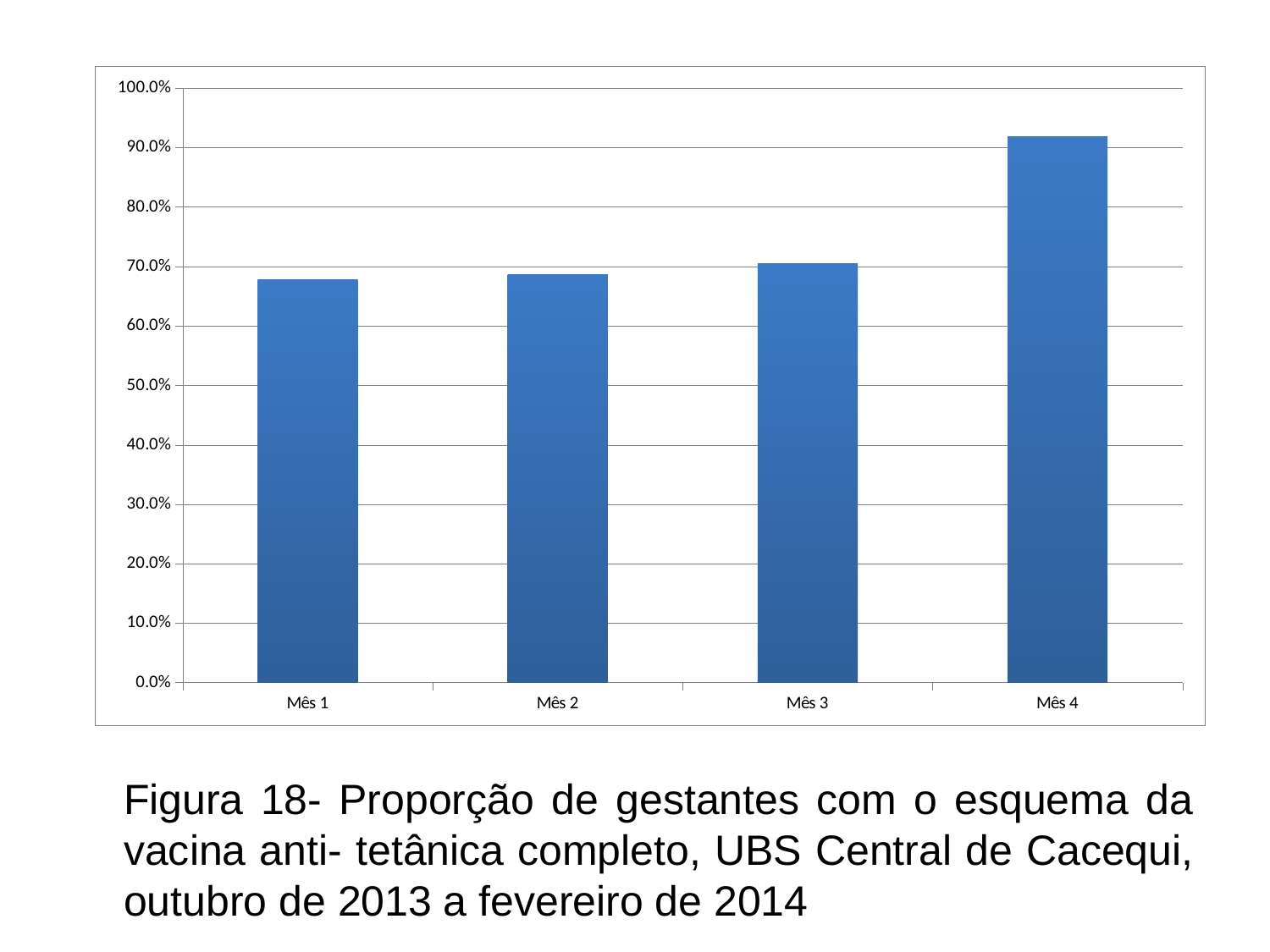
Is the value for Mês 2 greater or less than 60.0%? greater Which is larger, the value for Mês 4 or the value for Mês 1? Mês 4 How many categories (months) are plotted on the x axis? 4 Which is larger, the value for Mês 3 or the value for Mês 1? Mês 3 According to the caption, which figure number is this chart? Figura 18 Is the value for Mês 4 greater or less than 90.0%? greater What is the maximum value shown on the vertical axis? 100.0% Is the value for Mês 1 greater or less than 70.0%? less What kind of chart is shown on the slide? Bar chart Which month has the highest proportion? Mês 4 Do the values rise or fall from Mês 1 to Mês 4? Rise